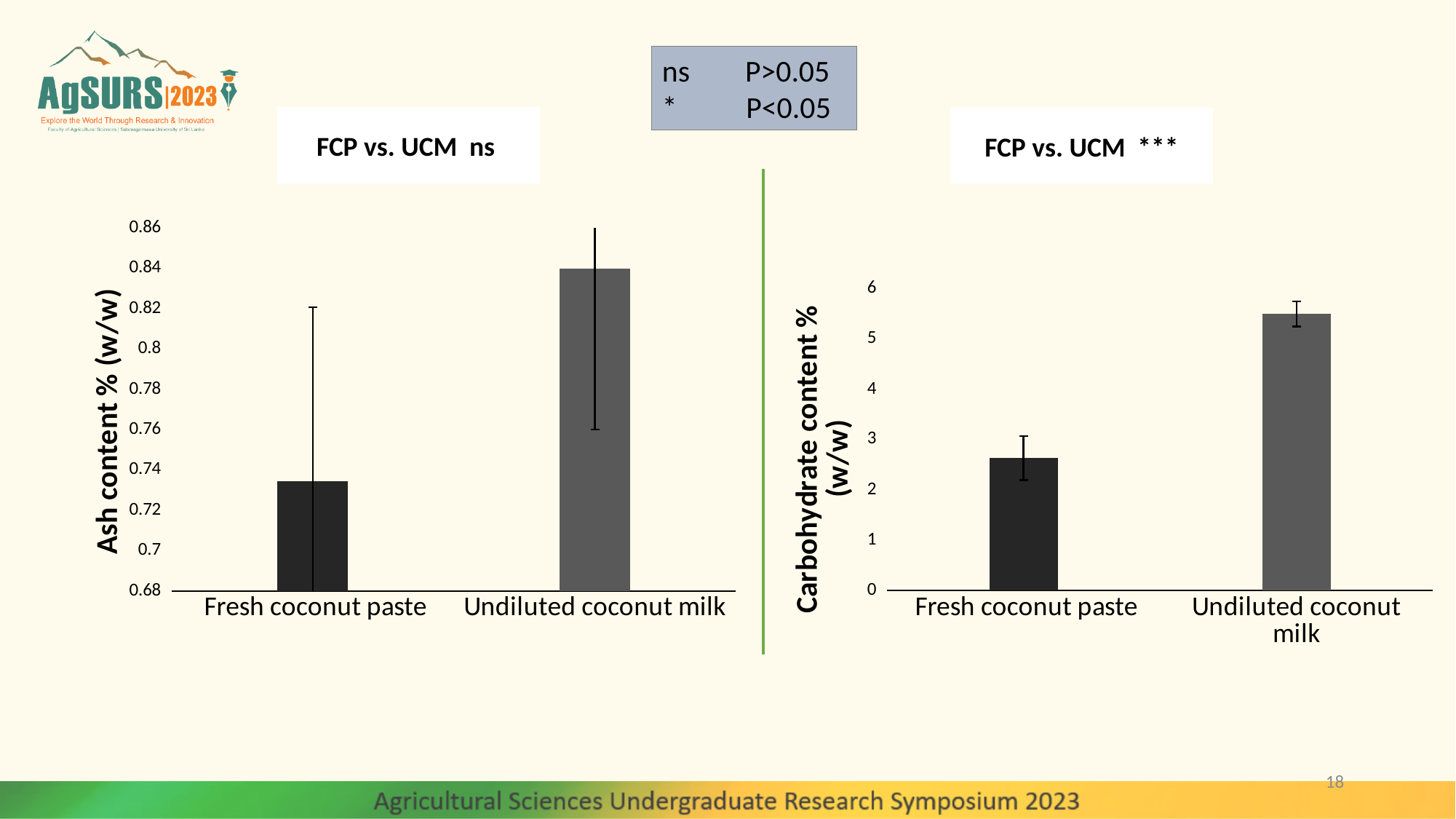
In the left chart (Ash content), is the value for Undiluted coconut milk greater or less than 0.8? greater What is the y-axis label of the right chart? Carbohydrate content % (w/w) In the right chart (Carbohydrate content), is the value for Undiluted coconut milk greater or less than 5? greater In the right chart (Carbohydrate content), is the value for Fresh coconut paste greater or less than 3? less In the left chart (Ash content), how many categories are shown on the x axis? 2 In the right chart (Carbohydrate content), is the bar for Undiluted coconut milk larger or smaller than the bar for Fresh coconut paste? larger What is the y-axis label of the left chart? Ash content % (w/w) In the right chart (Carbohydrate content), how many bars are plotted? 2 In the left chart (Ash content), which category has the higher bar? Undiluted coconut milk What kind of chart is the left chart showing ash content? bar chart In the right chart (Carbohydrate content), which category has the lower bar? Fresh coconut paste